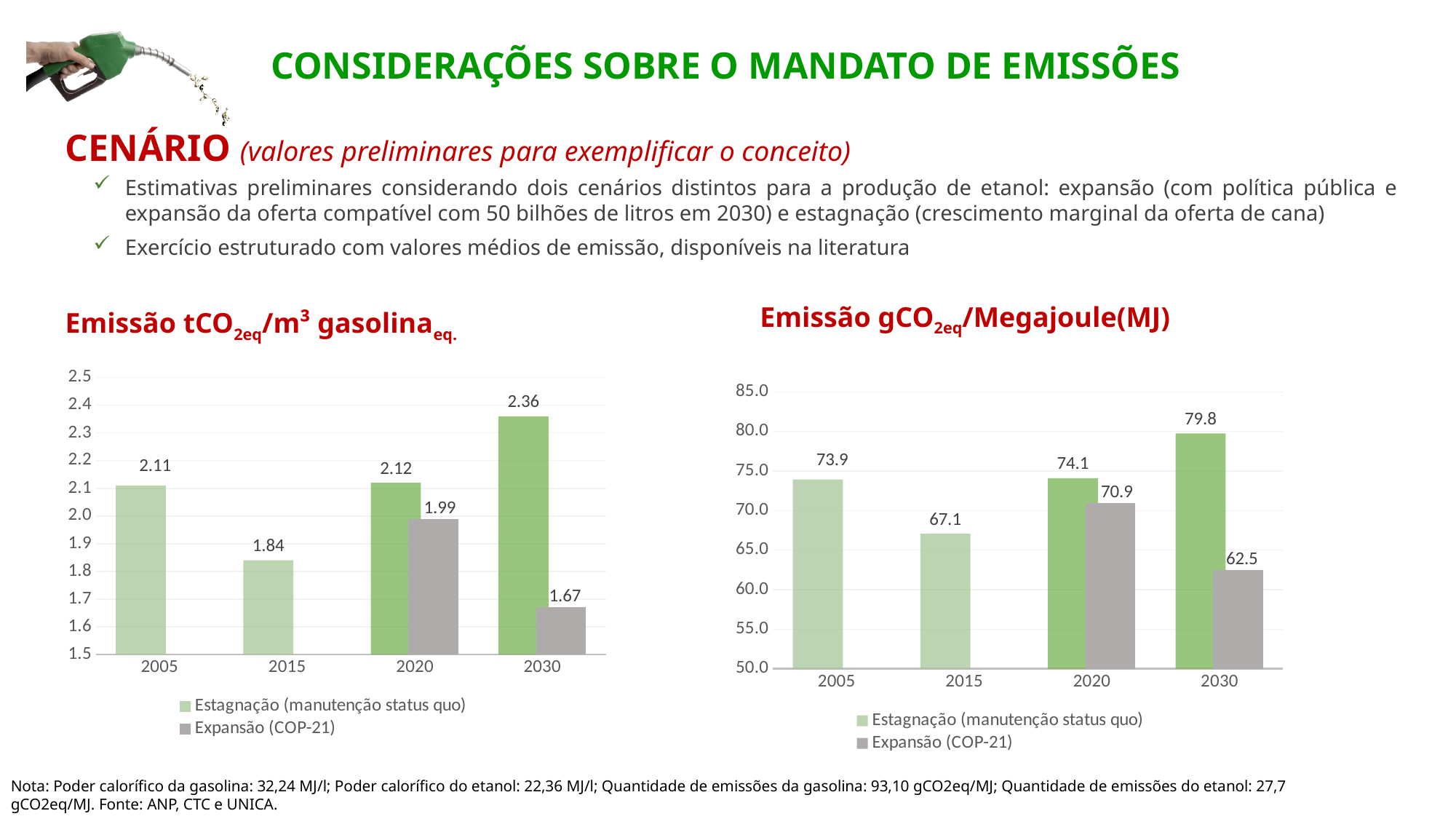
In the right chart (Emissão gCO2eq/Megajoule), what is the difference between the Estagnação and Expansão values for 2020? 3.2 In the left chart (Emissão tCO2eq/m³ gasolina eq.), what is the difference between the Estagnação and Expansão values for 2030? 0.69 How many years are shown on the x axis of the right chart (Emissão gCO2eq/Megajoule)? 4 In the left chart (Emissão tCO2eq/m³ gasolina eq.), what is the Estagnação value for 2030? 2.36 What type of chart is the left chart (Emissão tCO2eq/m³ gasolina eq.)? Bar chart In the right chart (Emissão gCO2eq/Megajoule), which year has the highest Estagnação value? 2030 In the left chart (Emissão tCO2eq/m³ gasolina eq.), what is the Expansão (COP-21) value for 2020? 1.99 In the right chart (Emissão gCO2eq/Megajoule), what is the Estagnação value for 2015? 67.1 In the right chart (Emissão gCO2eq/Megajoule), which is larger for 2030: the Estagnação value or the Expansão value? Estagnação In the left chart (Emissão tCO2eq/m³ gasolina eq.), how many series does the legend list? 2 In the left chart (Emissão tCO2eq/m³ gasolina eq.), which year has the lowest Estagnação value? 2015 In the right chart (Emissão gCO2eq/Megajoule), what is the Expansão (COP-21) value for 2030? 62.5